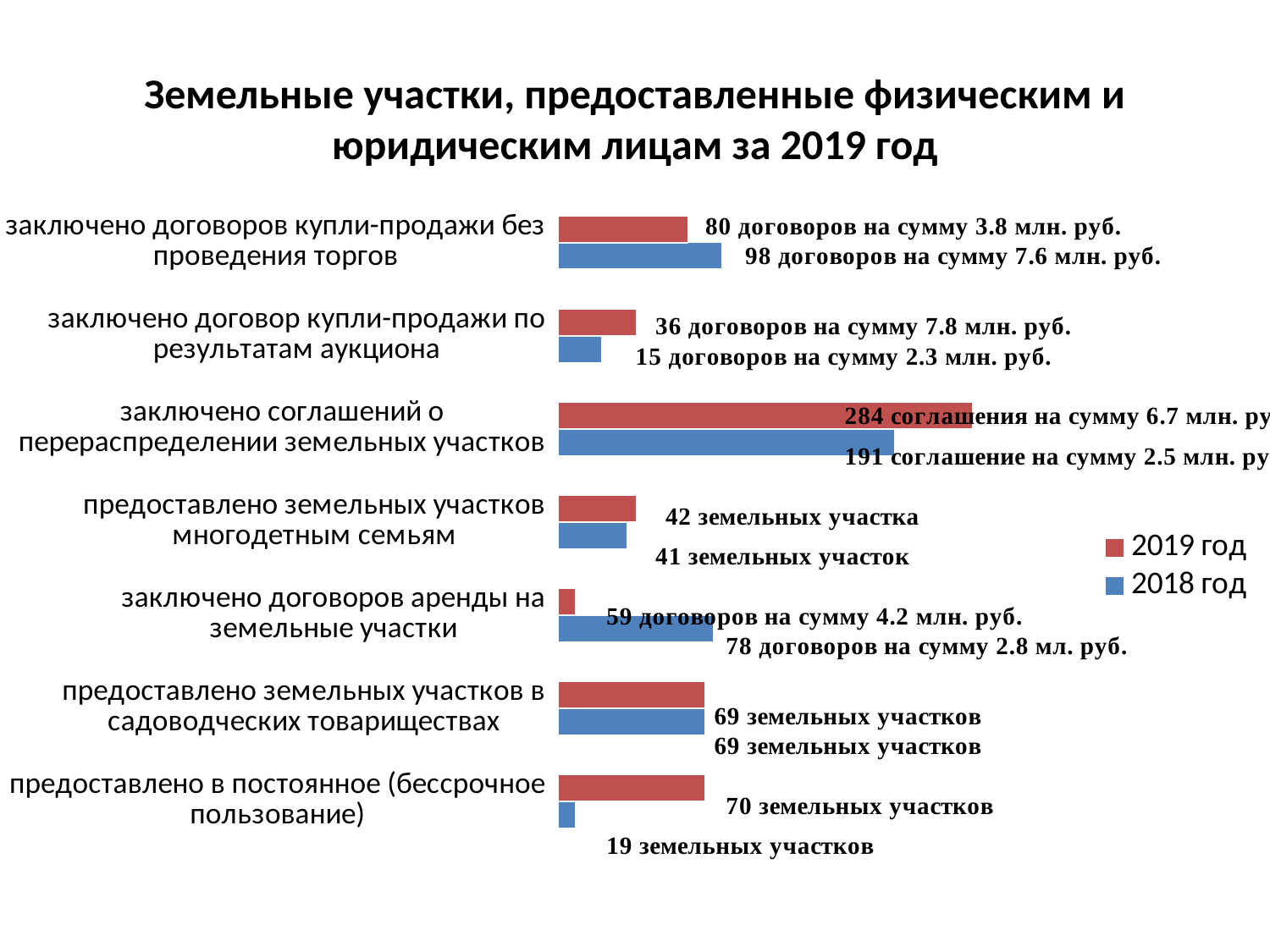
Which category has the highest value for 2019 год? заключено соглашений о перераспределении земельных участков How many соглашений о перераспределении земельных участков were concluded in 2019 год? 284 соглашения на сумму 6.7 млн. руб. What is the difference in the number of соглашений о перераспределении земельных участков between 2019 год and 2018 год? 93 How many земельных участков were предоставлено в постоянное (бессрочное пользование) in 2018 год? 19 земельных участков How many categories are shown on the chart? 7 What kind of chart is shown on the slide? bar chart Which year had more договоров купли-продажи без проведения торгов, 2019 год or 2018 год? 2018 год How many договоров купли-продажи без проведения торгов were concluded in 2019 год? 80 договоров на сумму 3.8 млн. руб. Which colour represents 2019 год in the legend? red Which category has the lowest value for 2018 год? предоставлено в постоянное (бессрочное пользование) How many series does the legend list? 2 How many договоров купли-продажи по результатам аукциона were concluded in 2018 год? 15 договоров на сумму 2.3 млн. руб.